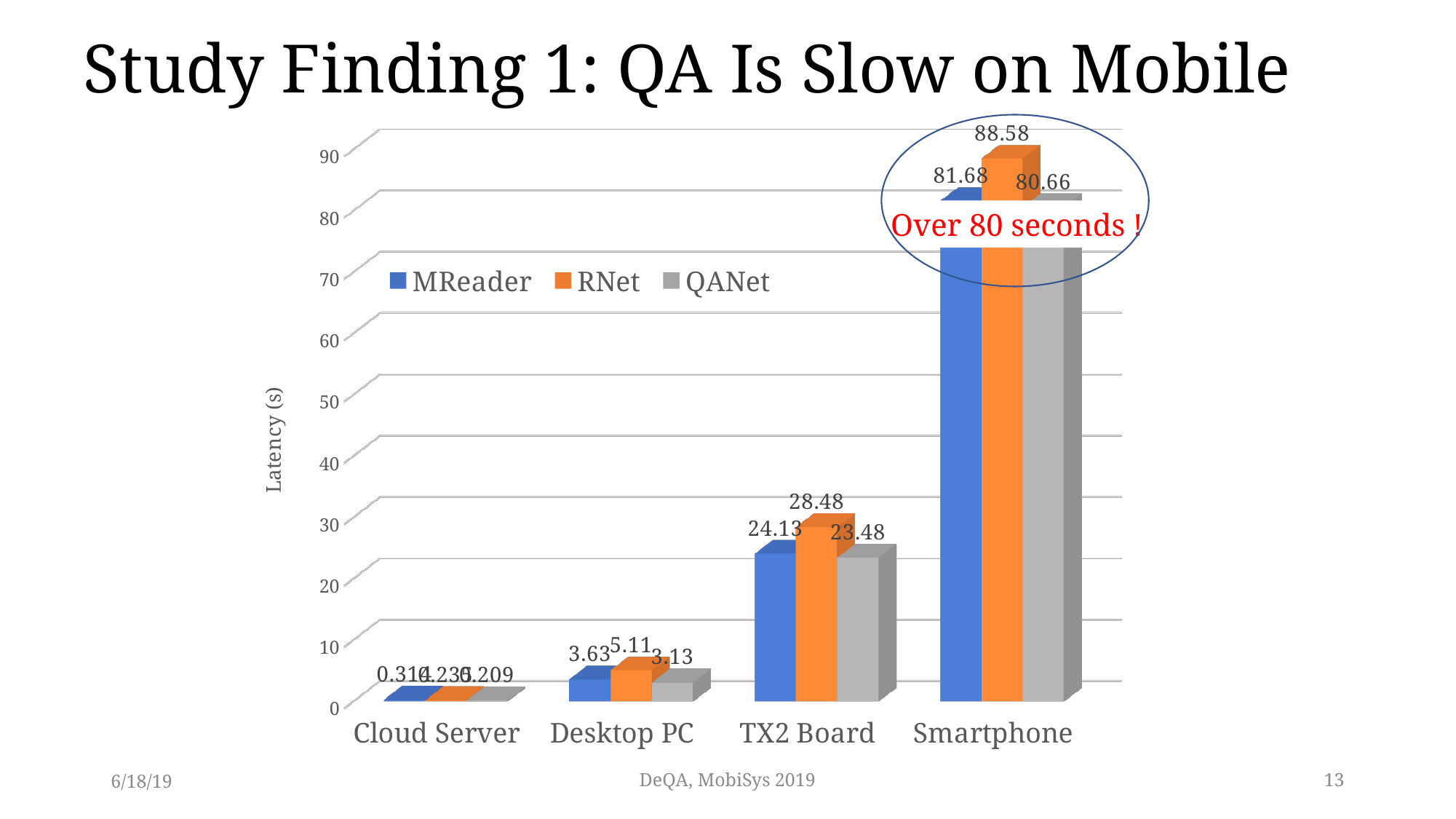
What is the latency for QANet on the Desktop PC? 3.13 Which device has the highest latency for RNet? Smartphone What is the difference between the RNet and QANet latencies on the TX2 Board? 5.00 What is the latency for RNet on the Smartphone? 88.58 What is the latency for MReader on the TX2 Board? 24.13 What is the latency for QANet on the Smartphone? 80.66 Which is larger on the Smartphone, the MReader latency or the QANet latency? MReader How many series does the legend list? 3 Which device has the lowest latency for MReader? Cloud Server Is the MReader latency on the Smartphone greater or less than 80? greater What kind of chart is shown on the slide? bar chart How many device categories are shown on the x axis? 4